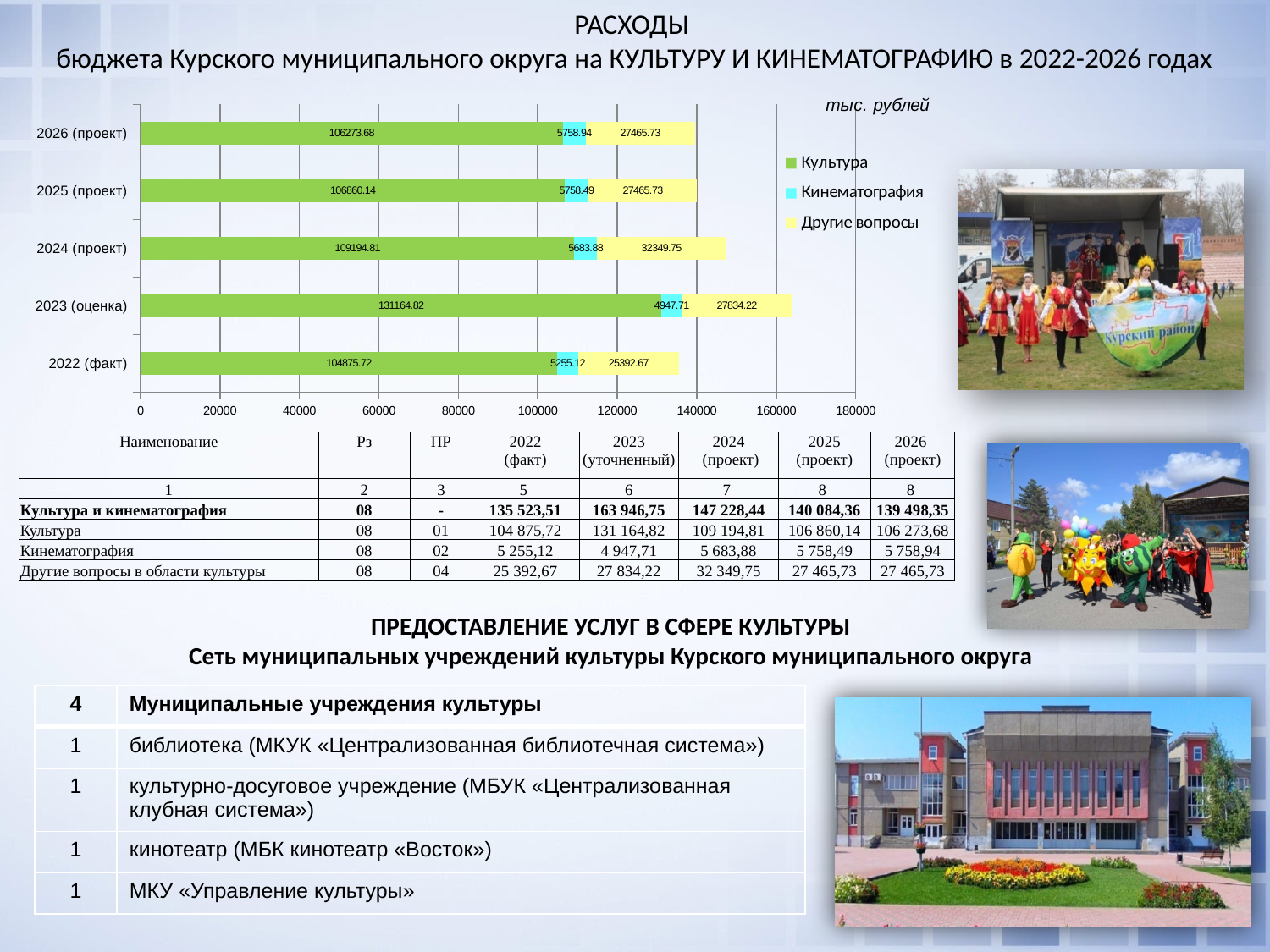
How many years are shown on the chart? 5 What kind of chart is shown on the slide? Stacked bar chart What is the difference between the Другие вопросы values for 2024 (проект) and 2023 (оценка)? 4515.53 Is the total length of the stacked bar for 2023 (оценка) greater or less than 160000? greater Which is larger, the Кинематография value for 2024 (проект) or for 2023 (оценка)? 2024 (проект) What is the total of the stacked bar for 2022 (факт)? 135523.51 Which year has the highest value for Культура? 2023 (оценка) Which year has the lowest value for Кинематография? 2023 (оценка) How many series does the legend list? 3 What is the value of Культура for 2023 (оценка)? 131164.82 What is the value of Другие вопросы for 2024 (проект)? 32349.75 What is the value of Кинематография for 2022 (факт)? 5255.12